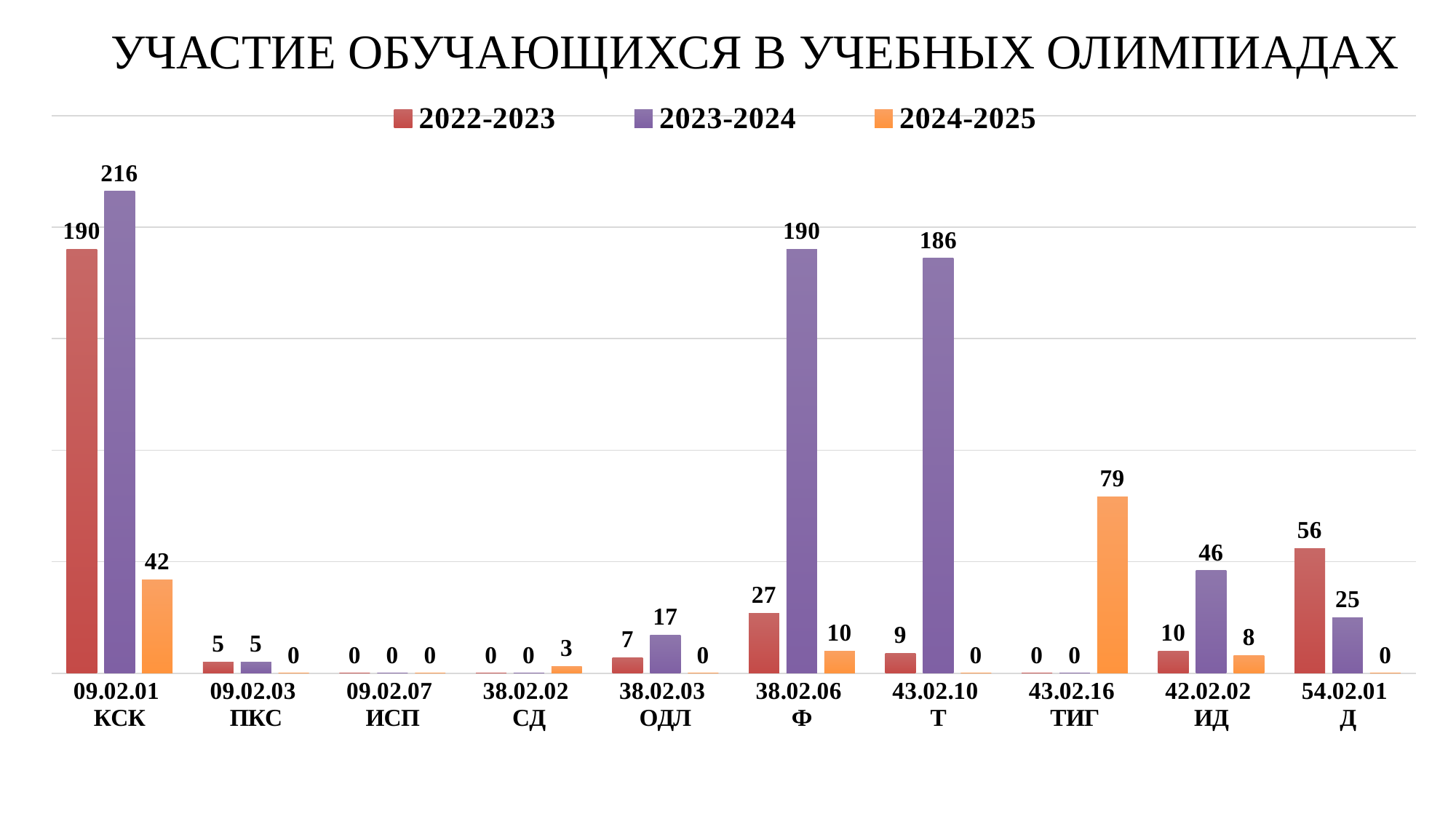
What type of chart is shown on the slide? bar chart How many series does the legend list? 3 What is the title of the chart? УЧАСТИЕ ОБУЧАЮЩИХСЯ В УЧЕБНЫХ ОЛИМПИАДАХ Which category has the highest value in the 2023-2024 series? 09.02.01 КСК Which is larger for 42.02.02 ИД: the 2022-2023 value or the 2023-2024 value? 2023-2024 What is the total of the three series values for 09.02.01 КСК? 448 How many categories are shown on the x axis? 10 What is the value for 43.02.16 ТИГ in the 2024-2025 series? 79 Which category has the highest value in the 2024-2025 series? 43.02.16 ТИГ What is the value for 54.02.01 Д in the 2022-2023 series? 56 What is the difference between the 2023-2024 and 2022-2023 values for 38.02.06 Ф? 163 What is the value for 09.02.01 КСК in the 2023-2024 series? 216